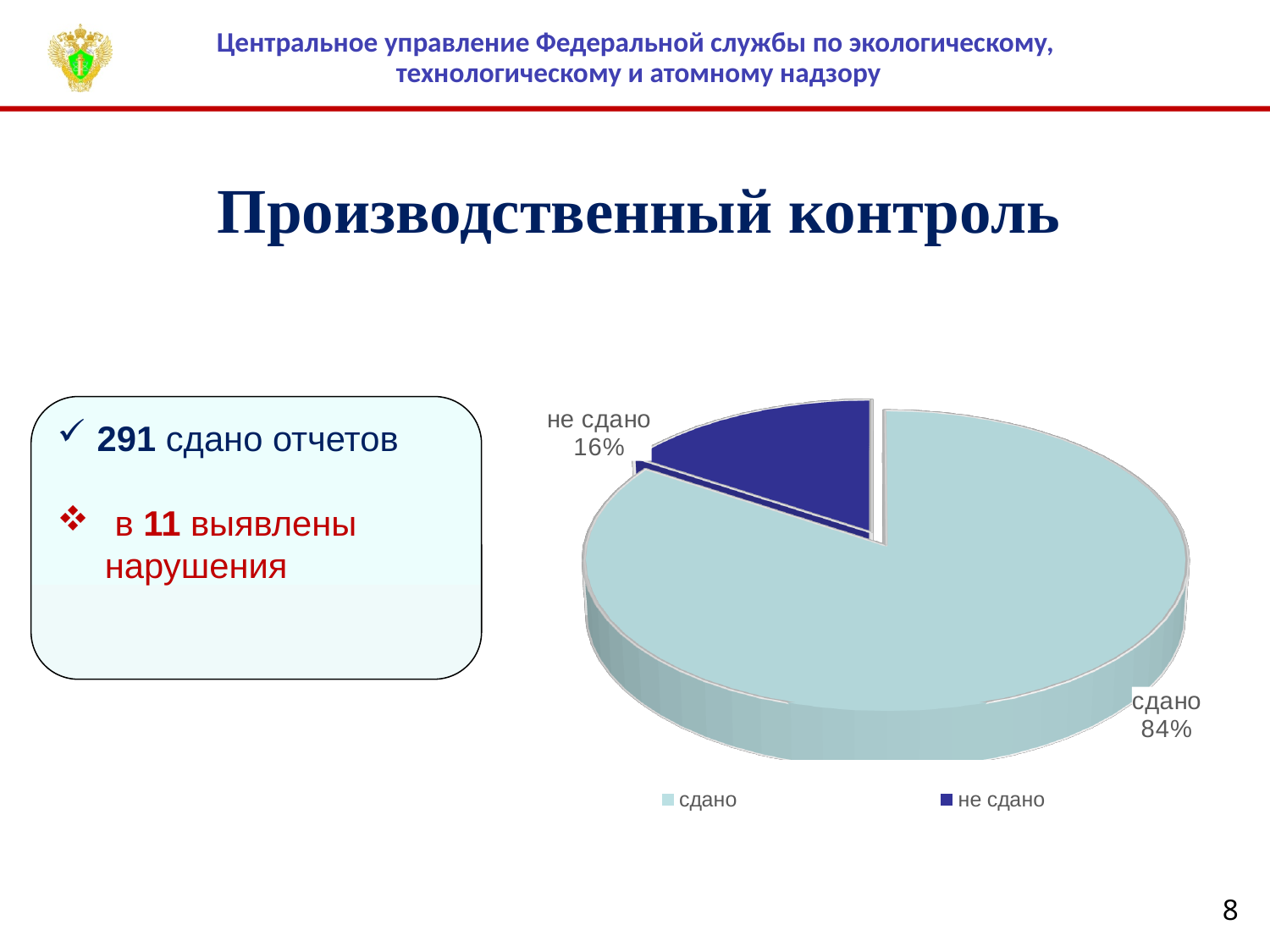
What is the title of the slide containing the pie chart? Производственный контроль What kind of chart is shown on the slide? pie chart Which slice is larger, "сдано" or "не сдано"? сдано What is the difference in percentage points between the "сдано" and "не сдано" slices? 68 Which slice of the pie chart is the largest? сдано What colour is the "не сдано" slice in the pie chart? dark blue How many entries does the chart legend list? 2 Which slice of the pie chart is the smallest? не сдано What share of the pie chart is labelled "сдано"? 84% How many slices does the pie chart have? 2 What share of the pie chart is labelled "не сдано"? 16%